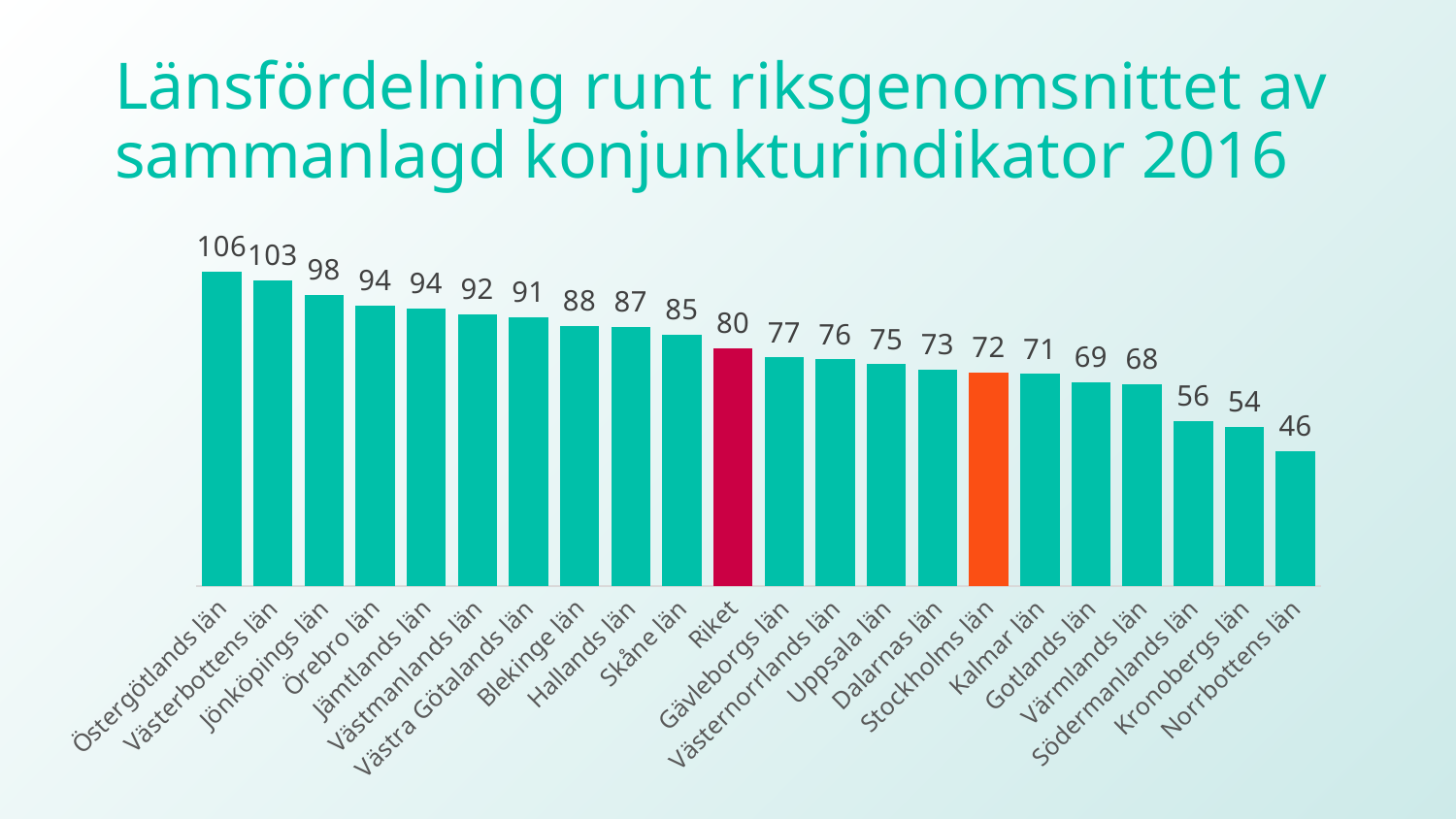
What kind of chart is shown on the slide? Bar chart What is the value for Riket? 80 Which is larger, the value for Skåne län or the value for Gävleborgs län? Skåne län Which category has the highest value? Östergötlands län How many bars are shown in the chart? 22 Do the values rise or fall from left to right along the x axis? Fall Which bar is coloured orange? Stockholms län What is the value for Stockholms län? 72 Which category has the lowest value? Norrbottens län What is the difference between the values for Riket and Stockholms län? 8 What is the value for Jönköpings län? 98 What is the difference between the values for Östergötlands län and Norrbottens län? 60